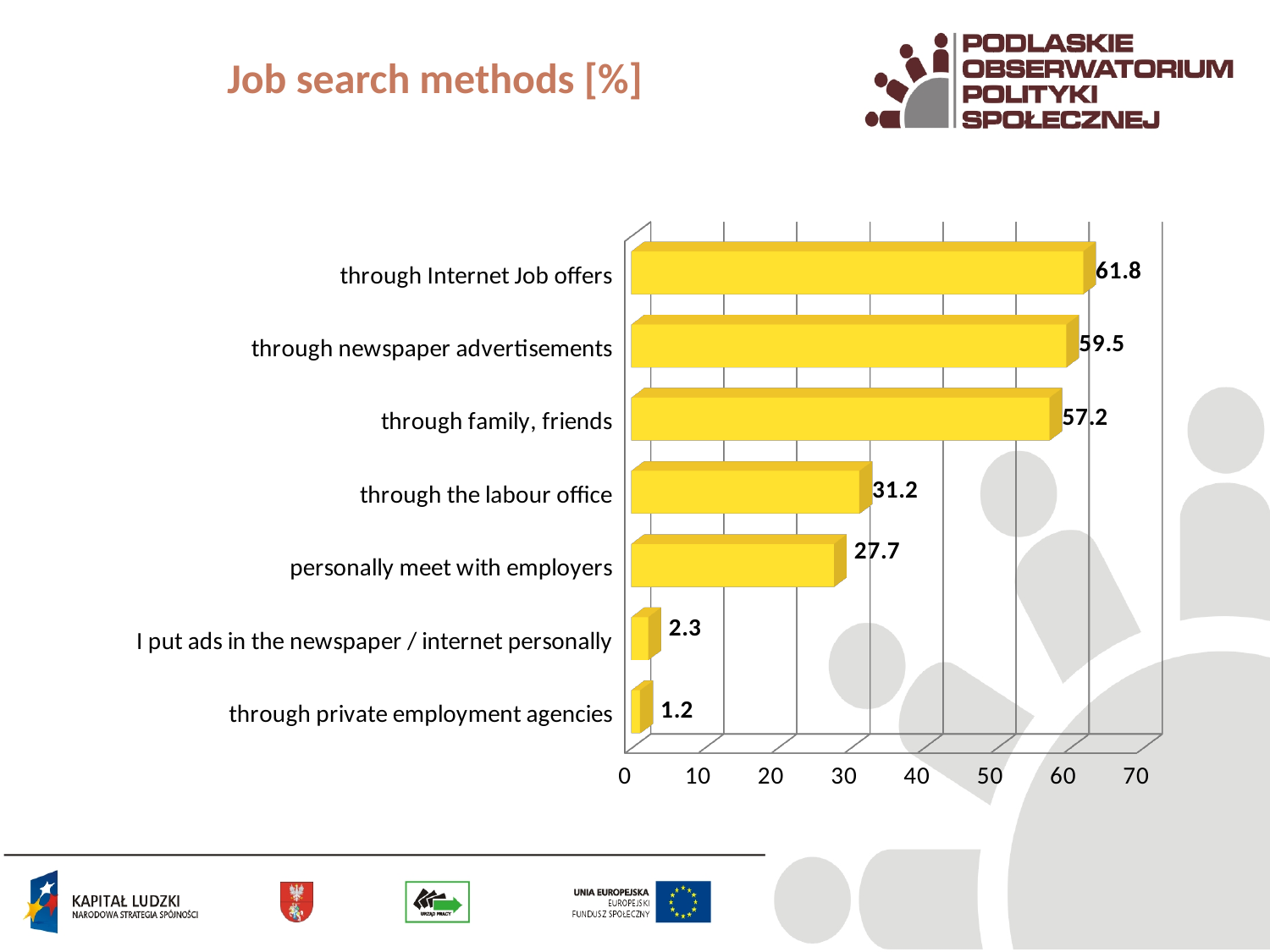
How many job search methods are shown in the chart? 7 What is the value for 'through private employment agencies'? 1.2 What is the value for 'through Internet Job offers'? 61.8 Which job search method has the lowest value? through private employment agencies Is the value for 'personally meet with employers' greater or less than 30? less What kind of chart is shown on the slide? bar chart What is the value for 'through the labour office'? 31.2 Which job search method has the highest value? through Internet Job offers Which is larger: 'through family, friends' or 'through the labour office'? through family, friends What is the difference between 'through the labour office' and 'personally meet with employers'? 3.5 What is the title of the chart? Job search methods [%] What is the difference between 'through Internet Job offers' and 'through newspaper advertisements'? 2.3